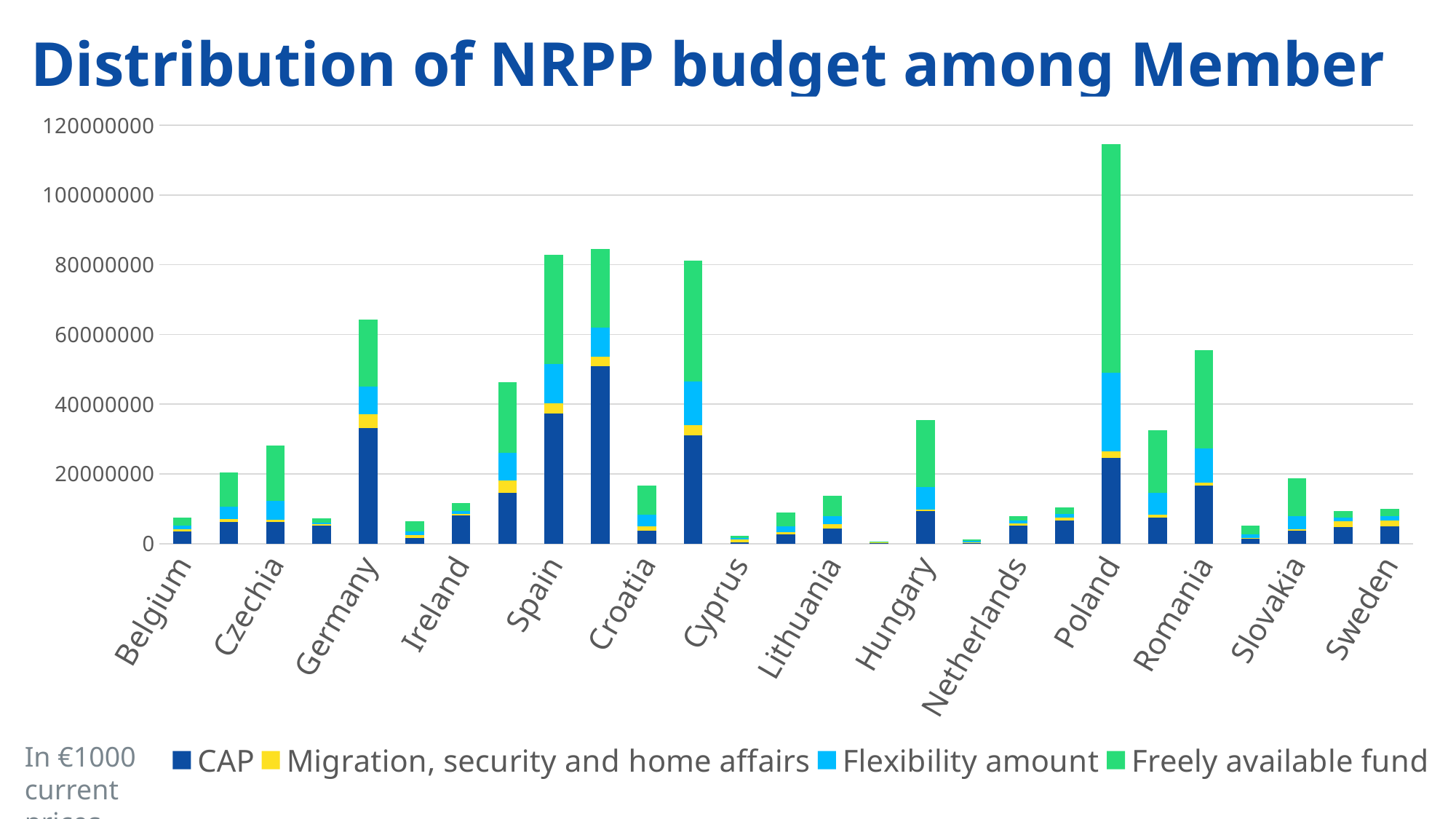
How many series does the legend list? 4 Of the countries labelled on the x axis, which has the shortest bar? Cyprus Which country has the tallest bar in the chart? Poland Which has the larger total bar, Czechia or Slovakia? Czechia Is the total value for Poland greater or less than 100000000? greater Is the total value for Germany greater or less than 60000000? greater Which has the larger total bar, Spain or Germany? Spain Which legend entry is shown in green? Freely available fund What kind of chart is shown on the slide? Stacked bar chart Is the total value for Romania greater or less than 60000000? less